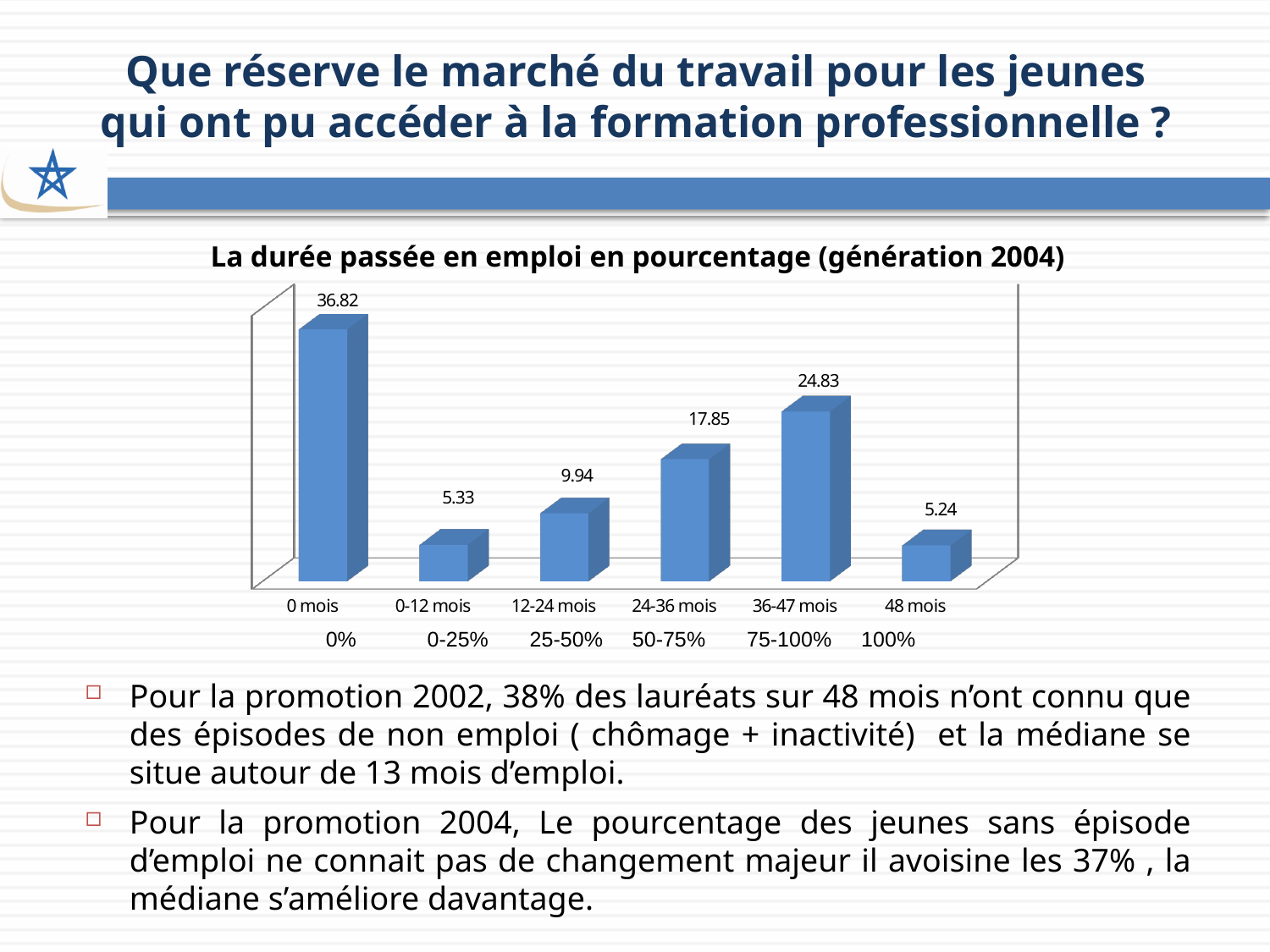
What is the value for the "12-24 mois" category? 9.94 What is the difference between the values for "0-12 mois" and "48 mois"? 0.09 What is the title of the chart? La durée passée en emploi en pourcentage (génération 2004) Which category has the lowest value? 48 mois How many categories are shown on the x axis? 6 What is the value for the "0 mois" category? 36.82 Which category has the highest value? 0 mois Which is larger, the value for "24-36 mois" or the value for "12-24 mois"? 24-36 mois What is the value for the "24-36 mois" category? 17.85 What is the difference between the values for "0 mois" and "36-47 mois"? 11.99 What is the value for the "36-47 mois" category? 24.83 What kind of chart is shown on the slide? Bar chart